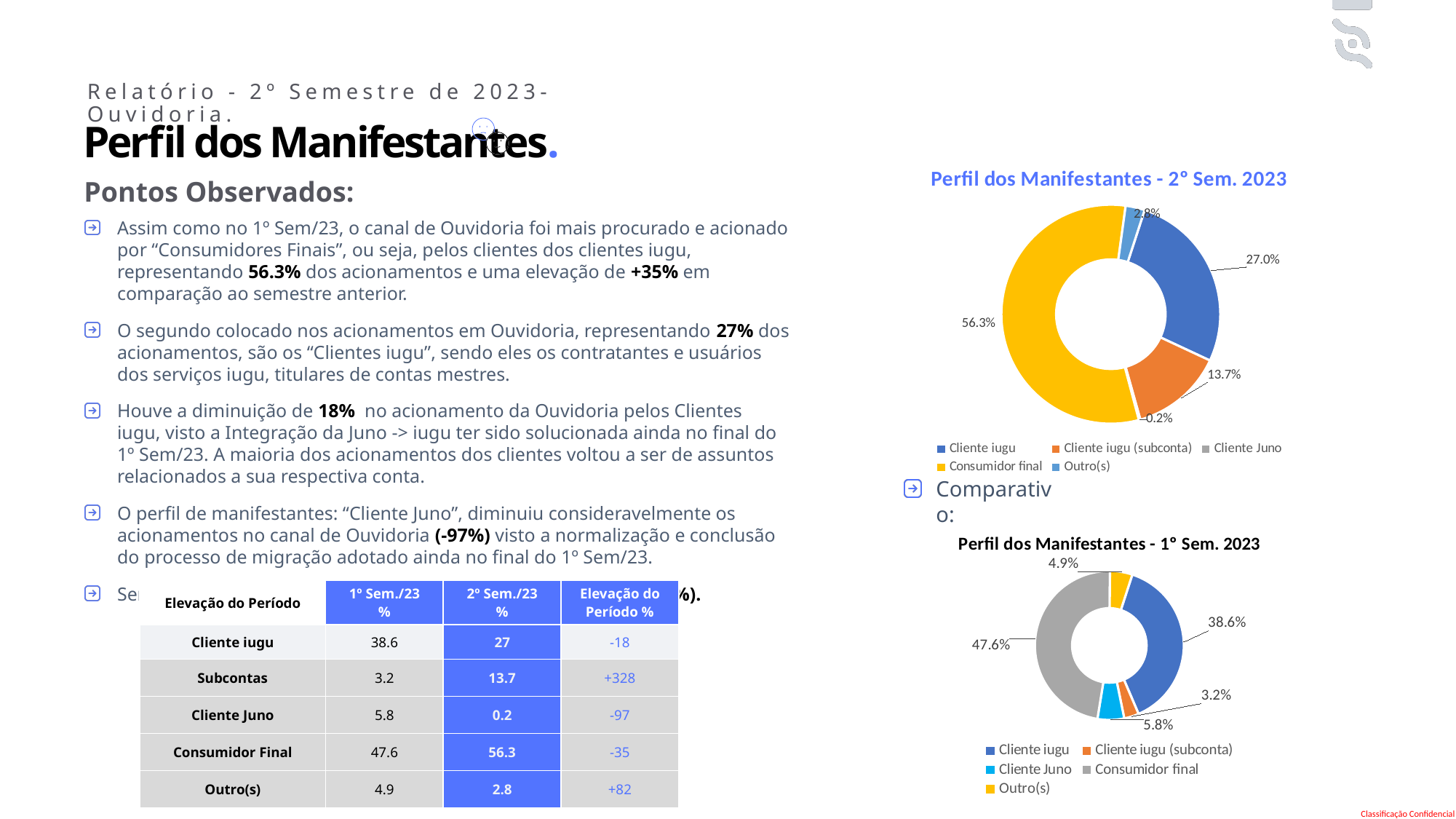
In the 'Perfil dos Manifestantes - 2° Sem. 2023' chart, what is the difference between the Cliente iugu share and the Cliente iugu (subconta) share? 13.3% How many categories does the legend of the 'Perfil dos Manifestantes - 1° Sem. 2023' chart list? 5 In the 'Perfil dos Manifestantes - 1° Sem. 2023' chart, which category has the largest share? Consumidor final In the 'Perfil dos Manifestantes - 2° Sem. 2023' chart, what share does Consumidor final have? 56.3% In the 'Perfil dos Manifestantes - 1° Sem. 2023' chart, which is larger: Outro(s) or Cliente iugu (subconta)? Outro(s) In the 'Perfil dos Manifestantes - 2° Sem. 2023' chart, which category has the smallest share? Cliente Juno What type of chart is 'Perfil dos Manifestantes - 1° Sem. 2023'? Doughnut chart In the 'Perfil dos Manifestantes - 2° Sem. 2023' chart, what colour is the Consumidor final slice? Yellow In the 'Perfil dos Manifestantes - 2° Sem. 2023' chart, what share does Cliente iugu (subconta) have? 13.7% In the 'Perfil dos Manifestantes - 1° Sem. 2023' chart, what share does Cliente iugu have? 38.6% In the 'Perfil dos Manifestantes - 2° Sem. 2023' chart, which category has the largest share? Consumidor final In the 'Perfil dos Manifestantes - 1° Sem. 2023' chart, what share does Cliente Juno have? 5.8%